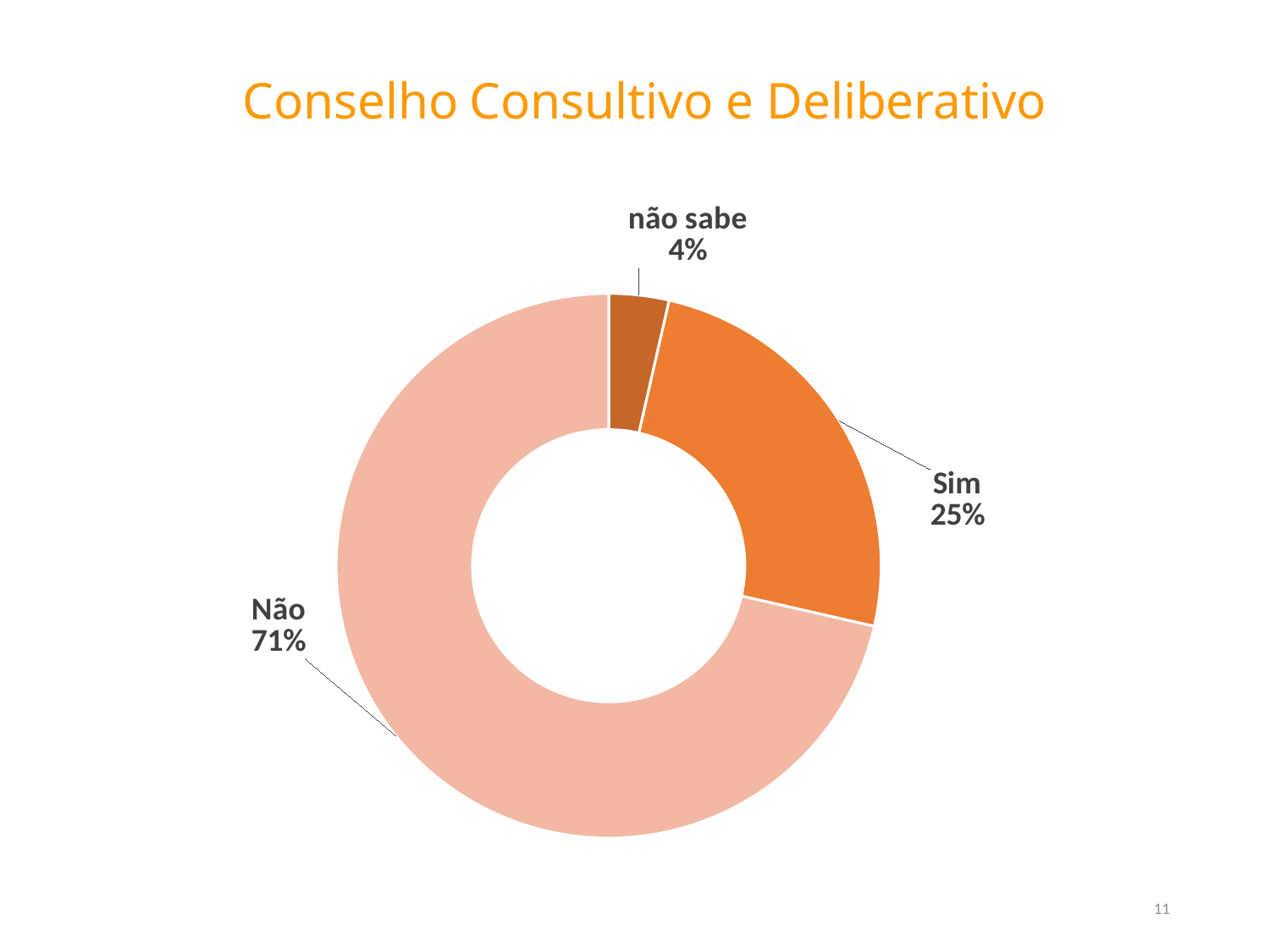
What is the difference in percentage points between "Não" and "Sim"? 46 How many categories are shown in the chart? 3 What is the title of the slide? Conselho Consultivo e Deliberativo What is the difference in percentage points between "Sim" and "não sabe"? 21 What share of the chart does the "Sim" slice represent? 25% Which category has the largest slice? Não What share of the chart does the "Não" slice represent? 71% Which is larger, the "Sim" slice or the "não sabe" slice? Sim What is the value shown for "não sabe"? 4% What kind of chart is shown on the slide? Doughnut (pie) chart Which category has the smallest slice? não sabe Which category is shown in the lightest colour? Não